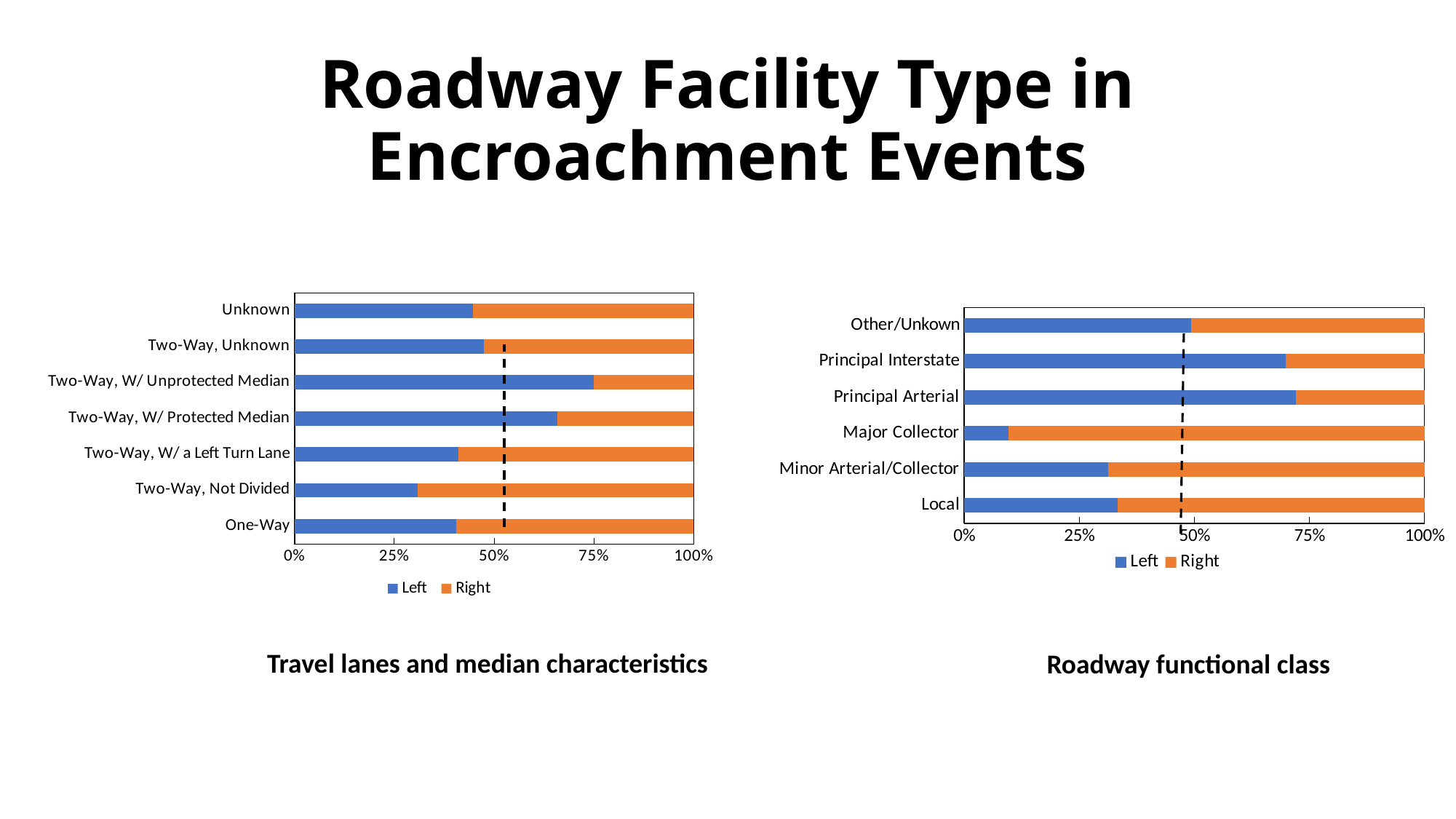
In the 'Roadway functional class' chart, which has the larger Left share, Principal Interstate or Minor Arterial/Collector? Principal Interstate In the 'Roadway functional class' chart, is the Left share for Principal Interstate greater or less than 50%? greater In the 'Travel lanes and median characteristics' chart, is the Left share for Two-Way, Not Divided greater or less than 50%? less In the 'Travel lanes and median characteristics' chart, which category has the largest Left share? Two-Way, W/ Unprotected Median In the 'Travel lanes and median characteristics' chart, what kind of chart is shown? Stacked bar chart In the 'Roadway functional class' chart, how many categories are plotted? 6 In the 'Travel lanes and median characteristics' chart, which colour represents the Right series? Orange In the 'Roadway functional class' chart, how many series does the legend list? 2 In the 'Travel lanes and median characteristics' chart, how many categories are plotted? 7 In the 'Roadway functional class' chart, which category has the smallest Left share? Major Collector In the 'Travel lanes and median characteristics' chart, which category has the smallest Left share? Two-Way, Not Divided In the 'Roadway functional class' chart, which category has the largest Right share? Major Collector